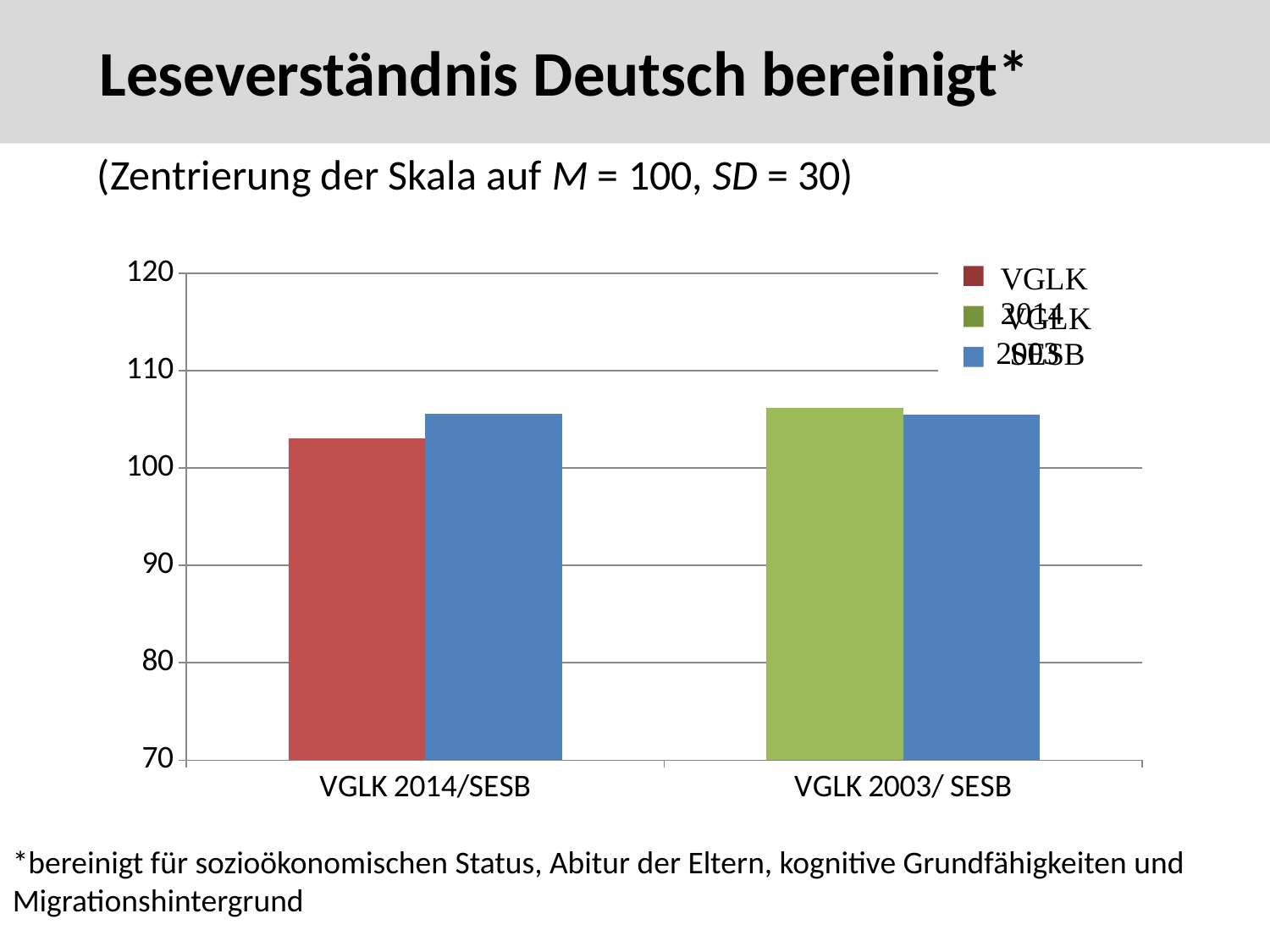
What is the title of the slide containing the chart? Leseverständnis Deutsch bereinigt* What kind of chart is shown on the slide? bar chart What is the lowest value shown on the chart's y axis? 70 Is the value of the green bar in the VGLK 2003/ SESB group greater or less than 100? greater In the VGLK 2014/SESB group, which bar is taller, the red bar or the blue bar? the blue bar How many categories are shown on the x axis of the chart? 2 Is the value of the blue bar in the VGLK 2014/SESB group greater or less than 110? less How many series does the chart's legend list? 3 Is the value of the blue bar in the VGLK 2003/ SESB group greater or less than 110? less Which bar is the lowest in the chart? the red bar (VGLK 2014)